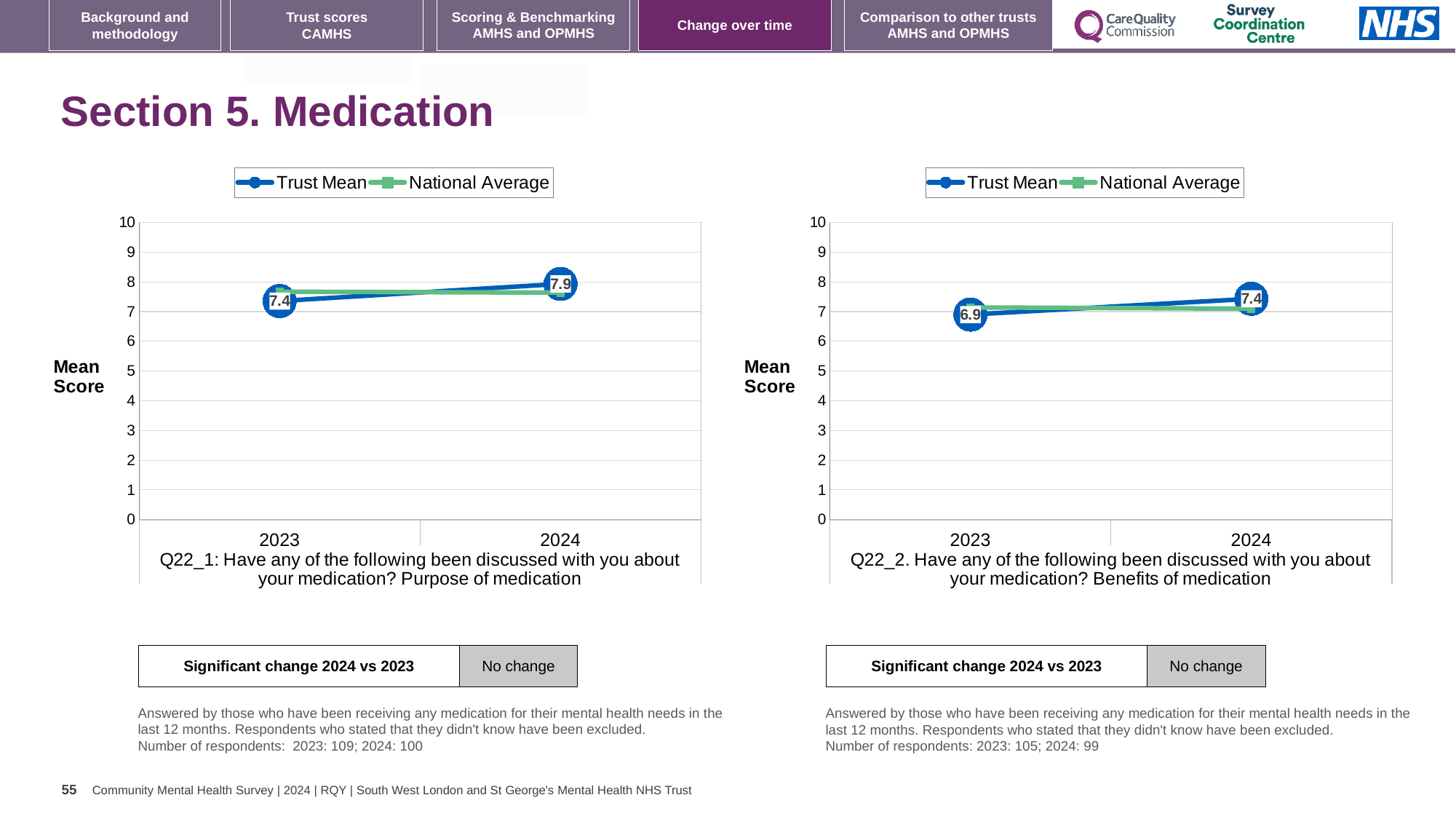
In the right chart (Q22_2: Benefits of medication), what is the Trust Mean score for 2024? 7.4 In the right chart (Q22_2: Benefits of medication), is the Trust Mean for 2023 greater or less than 7? less In the left chart (Q22_1: Purpose of medication), by how much did the Trust Mean change from 2023 to 2024? 0.5 In the left chart (Q22_1: Purpose of medication), what is the Trust Mean score for 2024? 7.9 In the left chart (Q22_1: Purpose of medication), what is the Trust Mean score for 2023? 7.4 In the right chart (Q22_2: Benefits of medication), what is the Trust Mean score for 2023? 6.9 In the right chart (Q22_2: Benefits of medication), does the Trust Mean rise or fall from 2023 to 2024? rise What type of chart is used on this slide? line chart How many series does the legend of the left chart list? 2 Which series is shown in blue in the left chart's legend? Trust Mean How many years are plotted on the x axis of the right chart? 2 In the right chart (Q22_2: Benefits of medication), what is the difference between the Trust Mean for 2024 and 2023? 0.5